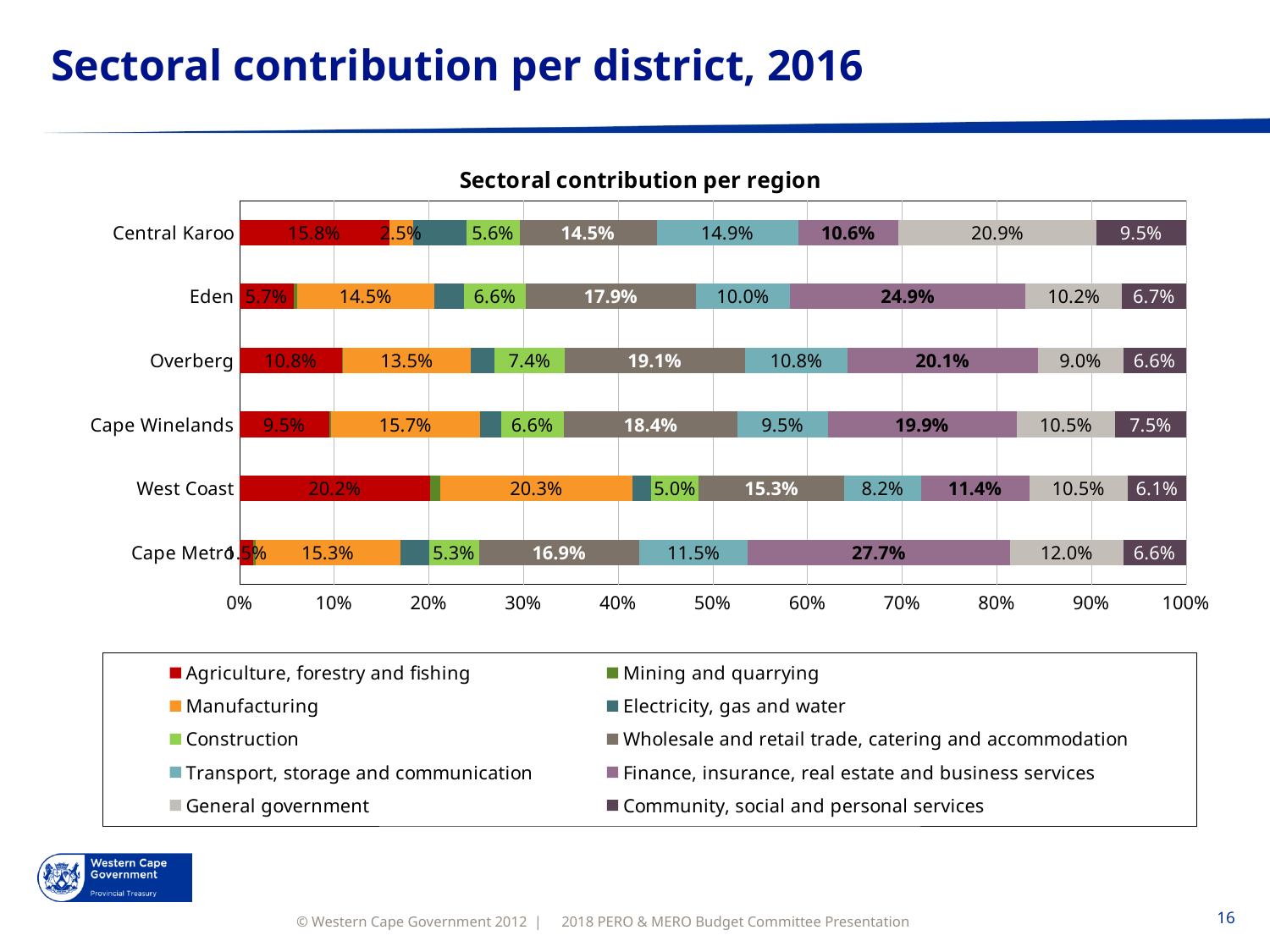
What is the contribution of General government for Central Karoo? 20.9% What is the title of the chart? Sectoral contribution per region What is the contribution of Agriculture, forestry and fishing for West Coast? 20.2% Which region has the larger Manufacturing contribution, West Coast or Central Karoo? West Coast How many sectors does the legend list? 10 What kind of chart is shown on the slide? Stacked bar chart How many regions are shown on the chart? 6 Which region has the highest contribution from Agriculture, forestry and fishing? West Coast What is the contribution of Finance, insurance, real estate and business services for Cape Metro? 27.7% Which region has the highest contribution from Finance, insurance, real estate and business services? Cape Metro What is the contribution of Wholesale and retail trade, catering and accommodation for Overberg? 19.1% What is the difference in the Finance, insurance, real estate and business services contribution between Eden and Overberg? 4.8 percentage points